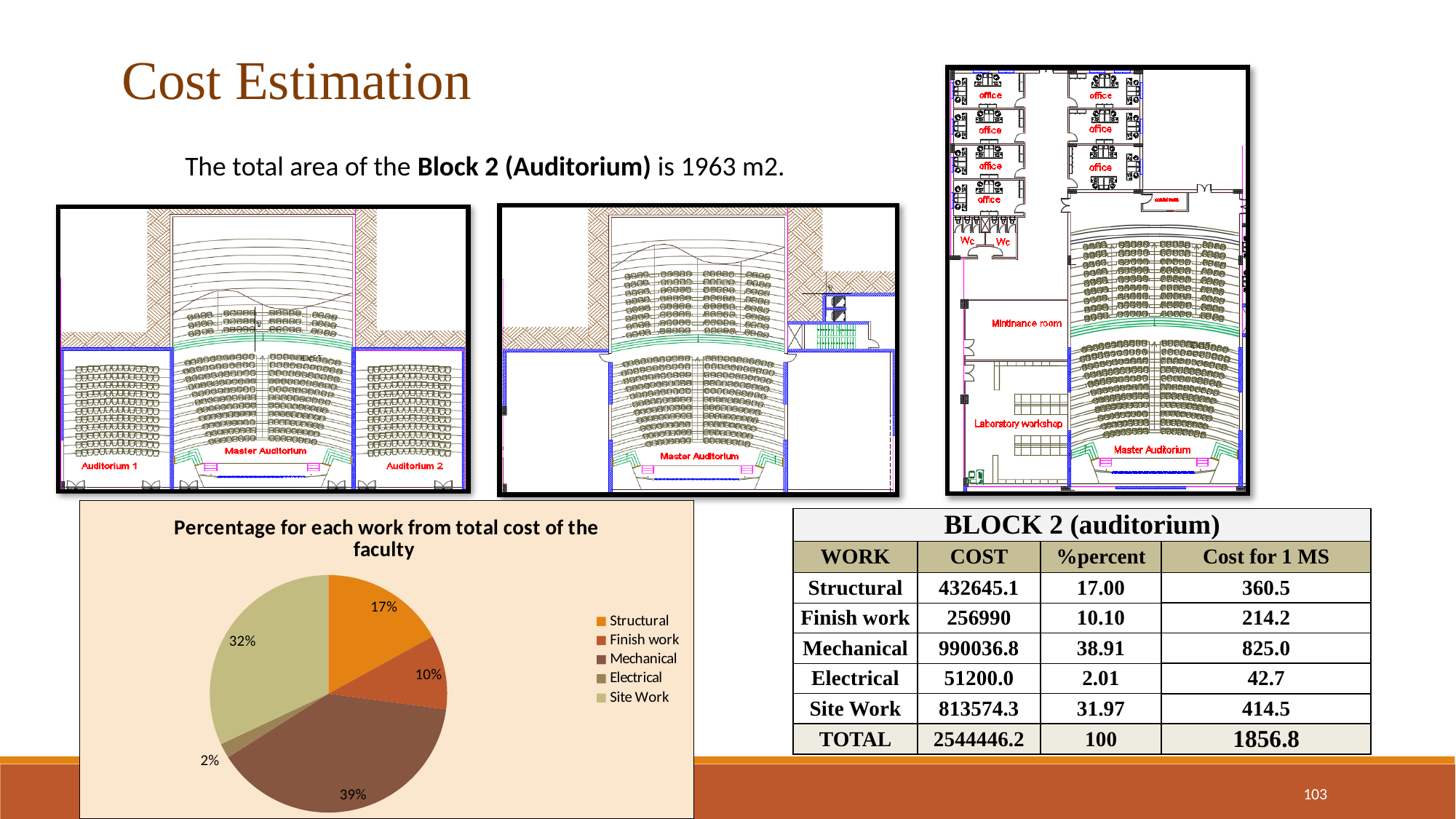
How many entries does the pie chart's legend list? 5 What percentage does the Structural slice show in the pie chart? 17% What percentage does the Mechanical slice show in the pie chart? 39% In the pie chart, what is the difference in percentage points between the Mechanical and Site Work slices? 7 Which work category has the smallest share in the pie chart? Electrical Which work category has the largest share in the pie chart? Mechanical What type of chart is shown on the slide? pie chart In the pie chart, which is larger: the Structural share or the Finish work share? Structural How many slices does the pie chart have? 5 What is the title of the pie chart? Percentage for each work from total cost of the faculty What percentage does the Site Work slice show in the pie chart? 32% What percentage does the Electrical slice show in the pie chart? 2%